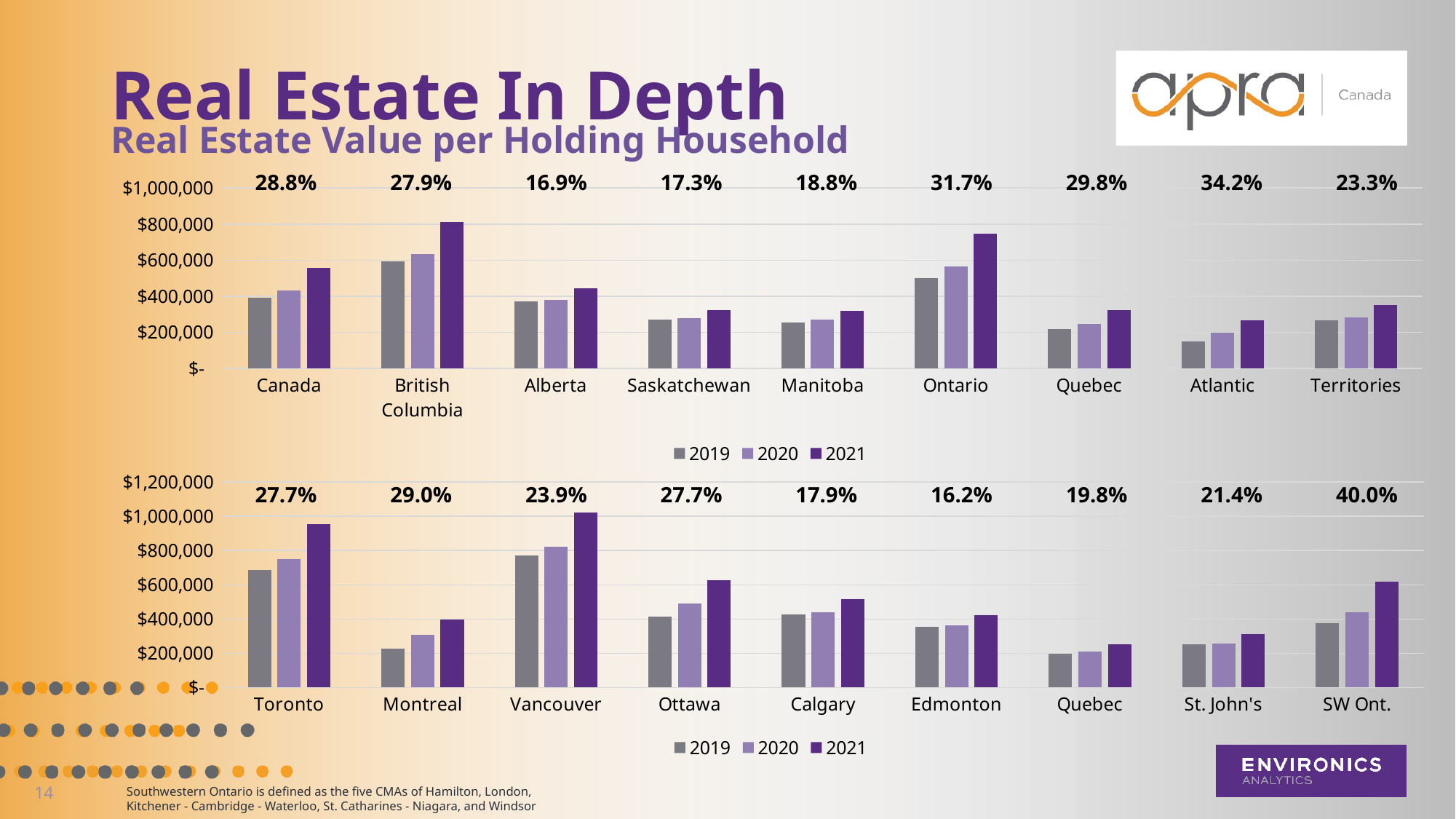
In the bottom chart, is the 2021 value for Toronto greater or less than $1,000,000? less In the top chart, what percentage is printed above the Ontario group? 31.7% In the bottom chart, what percentage is printed above the SW Ont. group? 40.0% How many series does the legend of the bottom chart list? 3 How many categories are shown on the x axis of the top chart? 9 In the bottom chart, which has the higher printed percentage, Montreal or Vancouver? Montreal What kind of chart is the top chart on the slide? bar chart In the top chart, is the 2021 value for Ontario greater or less than $800,000? less In the top chart, which category has the highest percentage printed above it? Atlantic In the top chart, what is the difference between the percentages printed above Atlantic and Alberta? 17.3% In the bottom chart, which category has the lowest percentage printed above it? Edmonton In the bottom chart, which category has the tallest 2021 bar? Vancouver